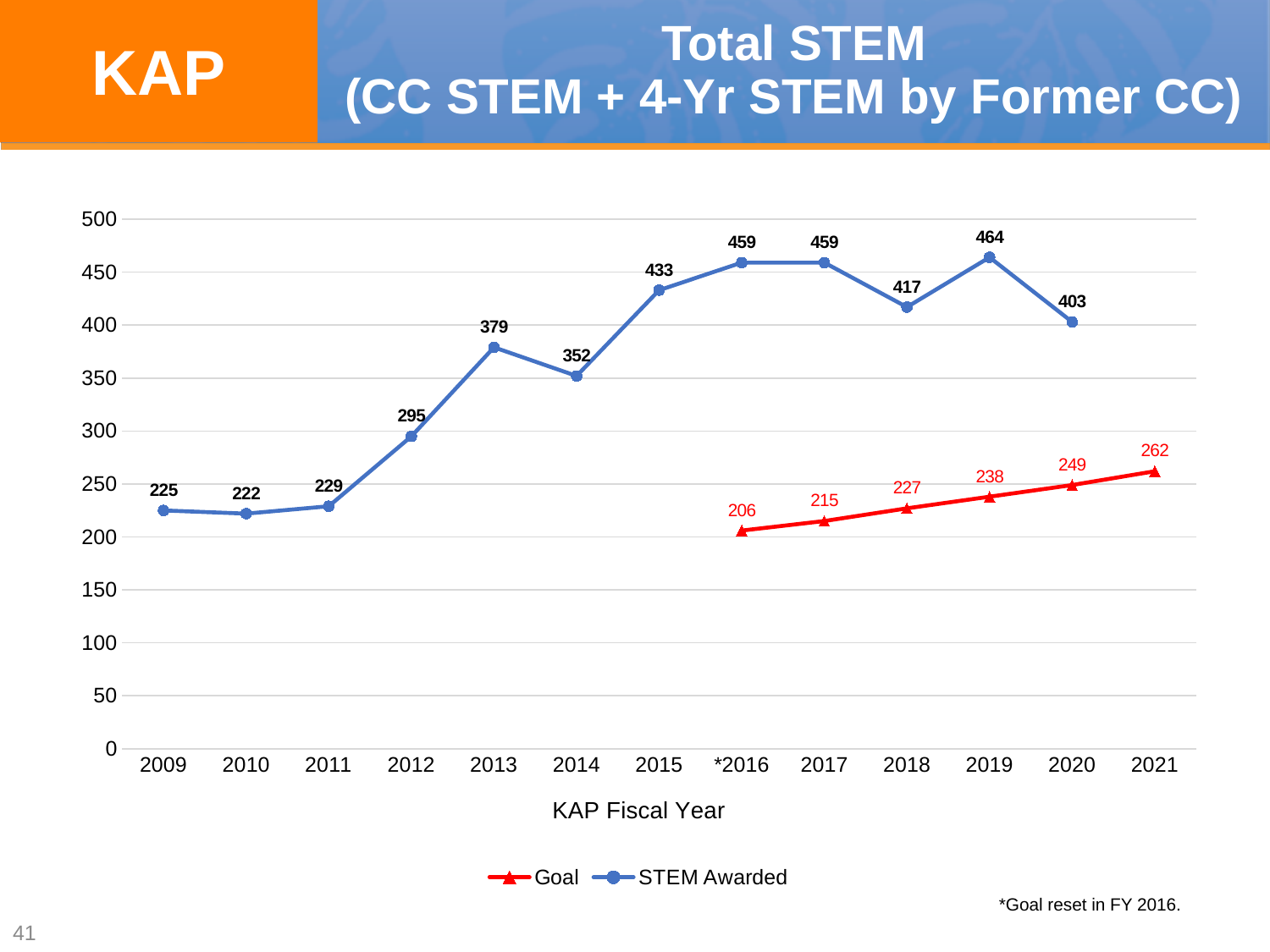
Is the STEM Awarded value for 2012 greater or less than 300? less In which year is the STEM Awarded value lowest? 2010 How many years are shown on the x axis? 13 Does the Goal series rise or fall from 2016 to 2021? rise In which year is the STEM Awarded value highest? 2019 What is the Goal value for 2019? 238 What is the label of the x axis? KAP Fiscal Year What kind of chart is shown on the slide? line chart What is the STEM Awarded value for 2013? 379 What is the difference between the STEM Awarded value in 2019 and the Goal value in 2019? 226 How many series does the legend list? 2 Which is larger, the STEM Awarded value for 2015 or for 2018? 2015